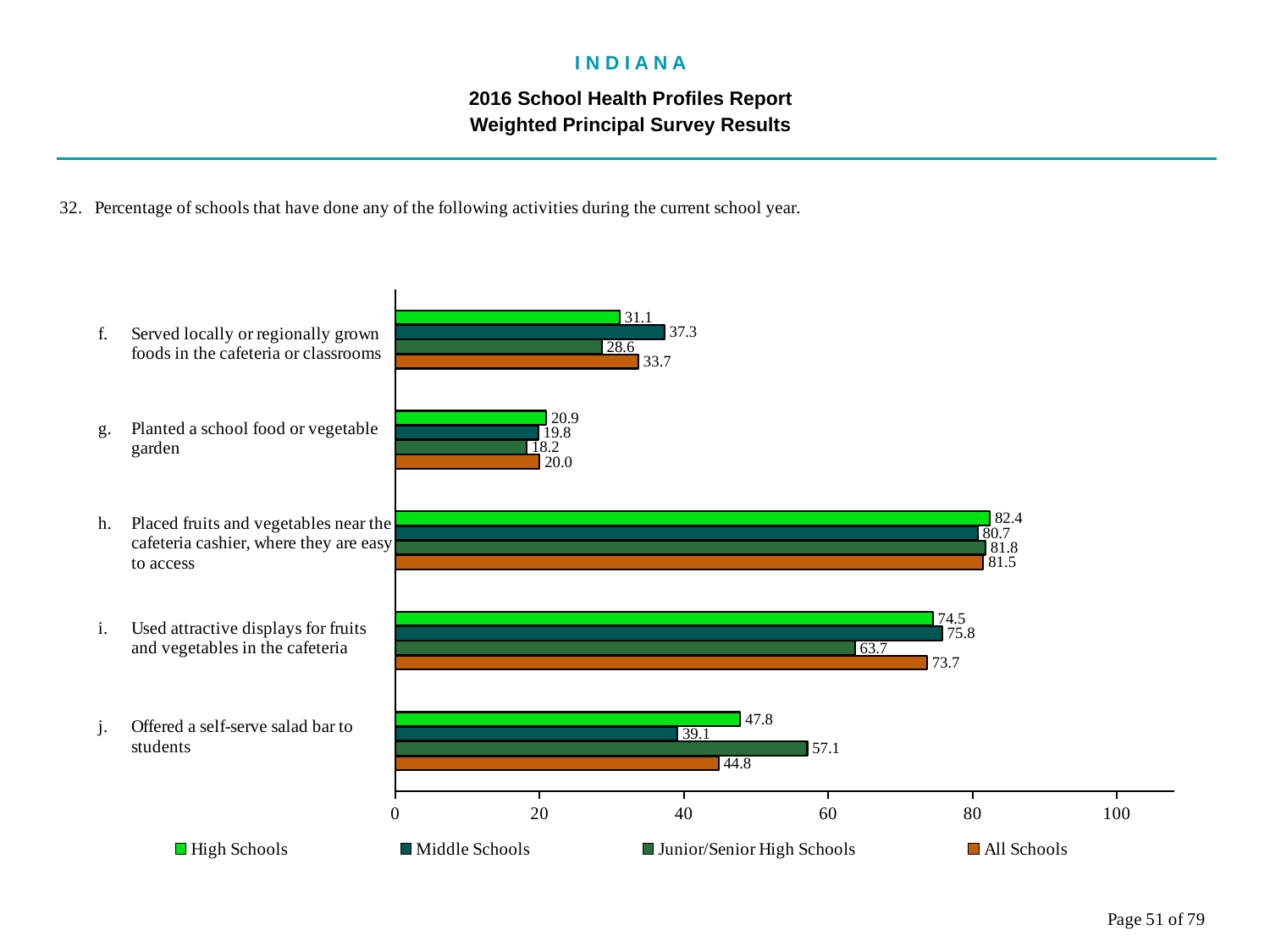
Is the All Schools value for 'Used attractive displays for fruits and vegetables in the cafeteria' greater or less than 60? greater What is the value for High Schools for 'Offered a self-serve salad bar to students'? 47.8 How many series does the legend list? 4 What is the All Schools value for 'Served locally or regionally grown foods in the cafeteria or classrooms'? 33.7 For 'Served locally or regionally grown foods in the cafeteria or classrooms', which is larger: the Middle Schools value or the High Schools value? Middle Schools What is the difference between the Junior/Senior High Schools and Middle Schools values for 'Offered a self-serve salad bar to students'? 18.0 Which series is shown in orange in the legend? All Schools Which activity has the lowest High Schools value? Planted a school food or vegetable garden How many activities (categories) are shown on the chart? 5 What is the value for Junior/Senior High Schools for 'Used attractive displays for fruits and vegetables in the cafeteria'? 63.7 What kind of chart is shown on the slide? bar chart Which activity has the highest All Schools value? Placed fruits and vegetables near the cafeteria cashier, where they are easy to access